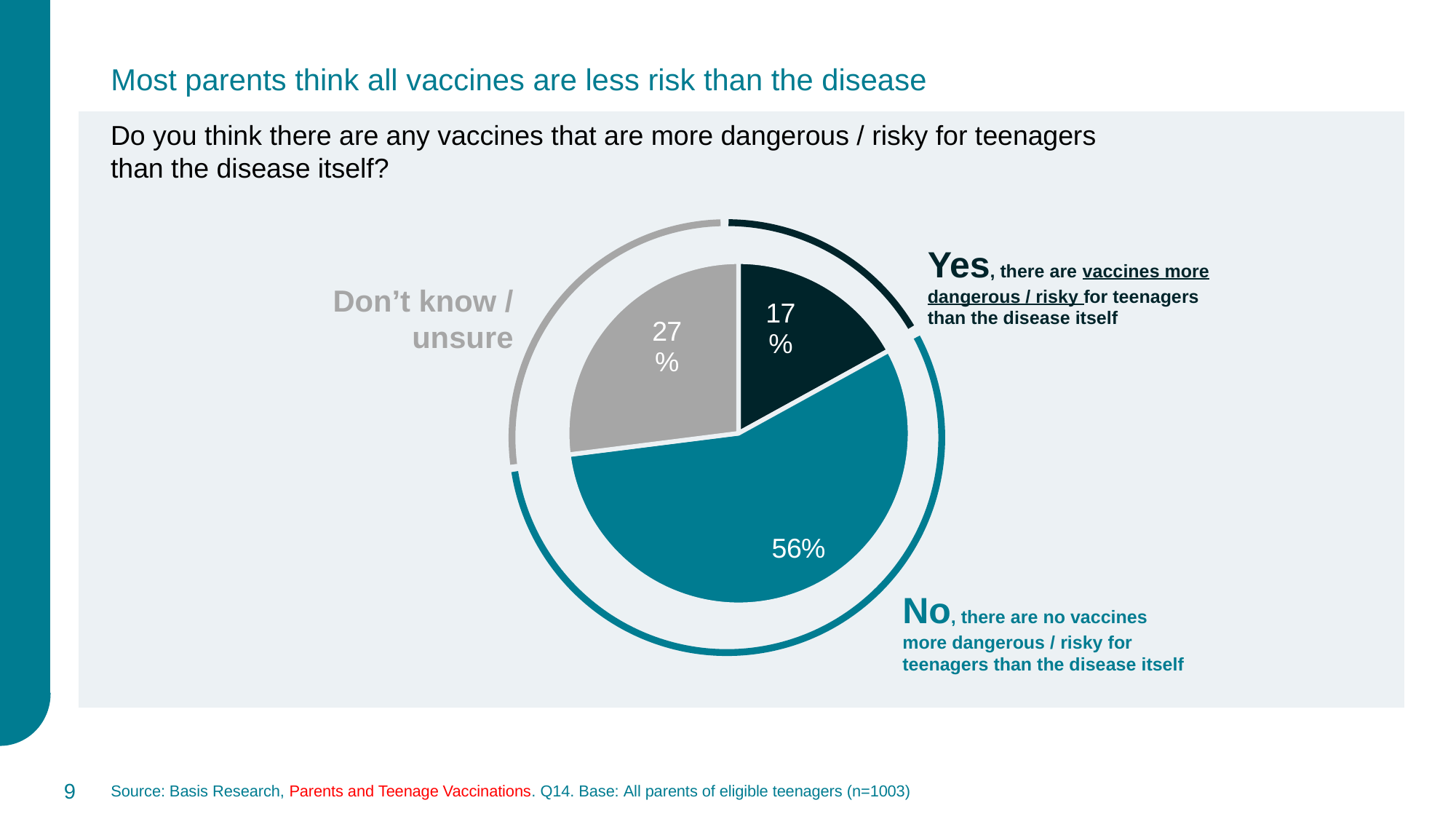
Which is larger, the share for "Don't know / unsure" or the share for "Yes"? Don't know / unsure What percentage of parents answered "Don't know / unsure"? 27% What percentage of parents answered "Yes"? 17% What is the difference in percentage points between the "Don't know / unsure" and "Yes" responses? 10 What is the difference in percentage points between the "No" and "Yes" responses? 39 What percentage of parents answered "No"? 56% Which response has the largest share of the pie? No What kind of chart is shown on the slide? Pie chart What colour is the "No" slice of the pie? Teal How many slices does the pie chart have? 3 What is the survey question shown above the pie chart? Do you think there are any vaccines that are more dangerous / risky for teenagers than the disease itself? Which response has the smallest share of the pie? Yes